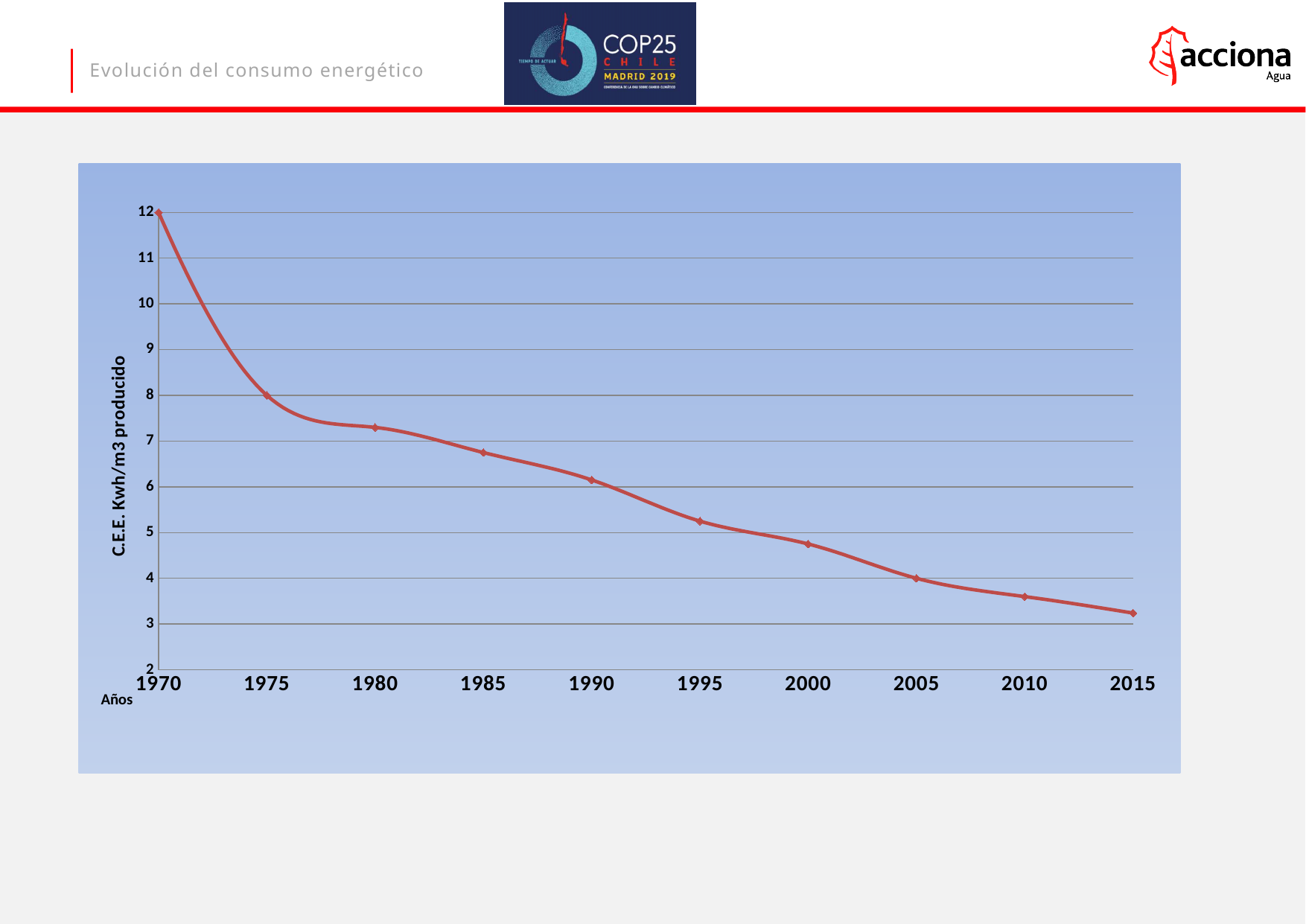
What is the value for 1970? 12 Which year has the lowest value? 2015 How many data points are plotted on the line? 10 Is the value for 2015 greater or less than 4? less Which is larger, the value for 1990 or the value for 2000? 1990 What is the difference between the values for 1970 and 1975? 4 What kind of chart is shown on the slide? line chart What is the value for 2005? 4 Is the value for 1995 greater or less than 5? greater Which year has the highest value? 1970 What is the difference between the values for 1975 and 2005? 4 What is the value for 1975? 8